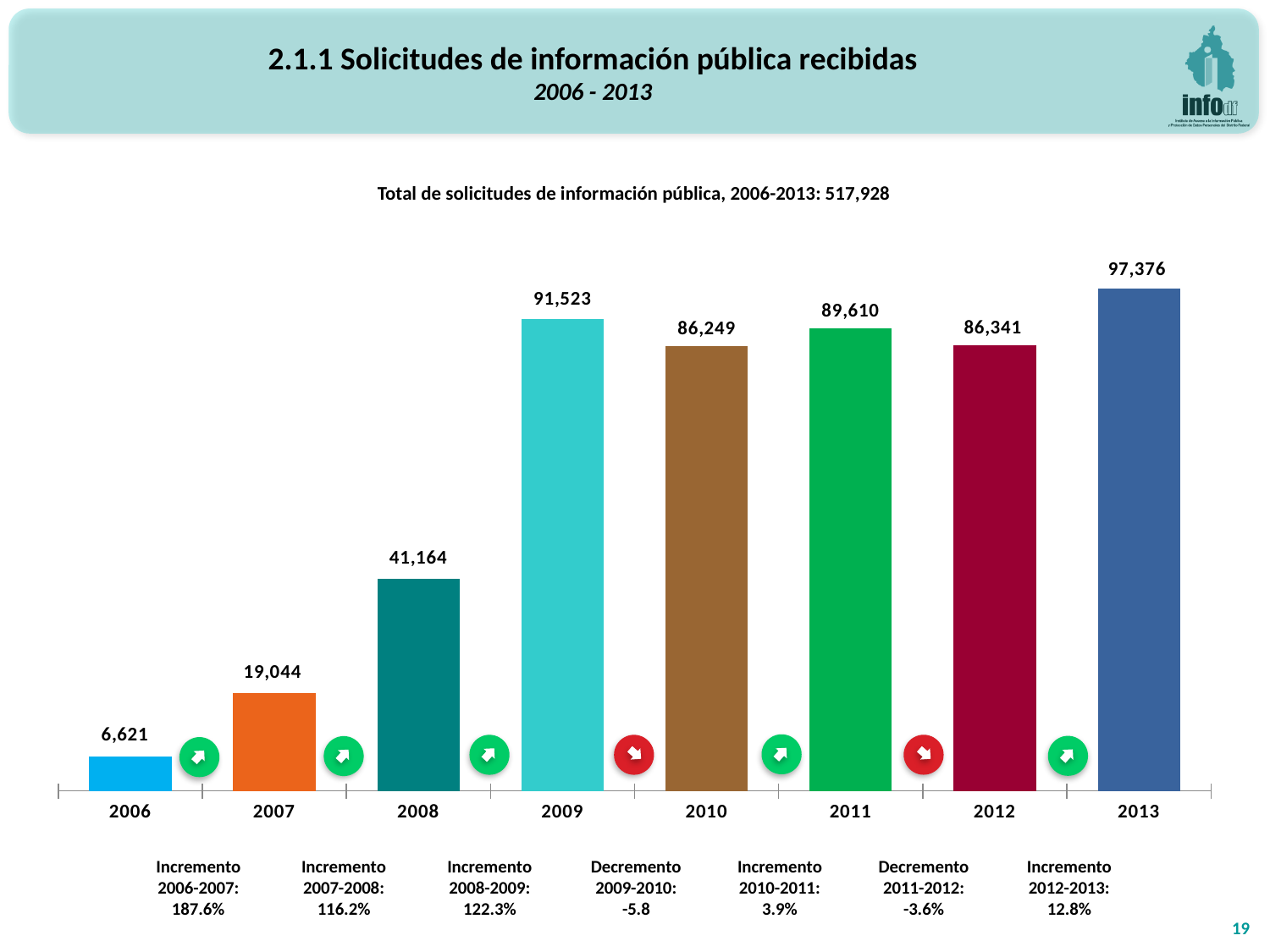
What is the value for 2012? 86,341 What is the difference between the values for 2008 and 2007? 22,120 Which year has the highest value? 2013 How many years are shown on the x axis? 8 What is the value for 2009? 91,523 What is the difference between the values for 2013 and 2012? 11,035 What is the value for 2006? 6,621 Which year has the lowest value? 2006 Which is larger, the value for 2010 or the value for 2011? 2011 Do the values rise or fall from 2006 to 2009? rise What kind of chart is shown on the slide? bar chart What total of solicitudes for 2006-2013 is stated above the chart? 517,928